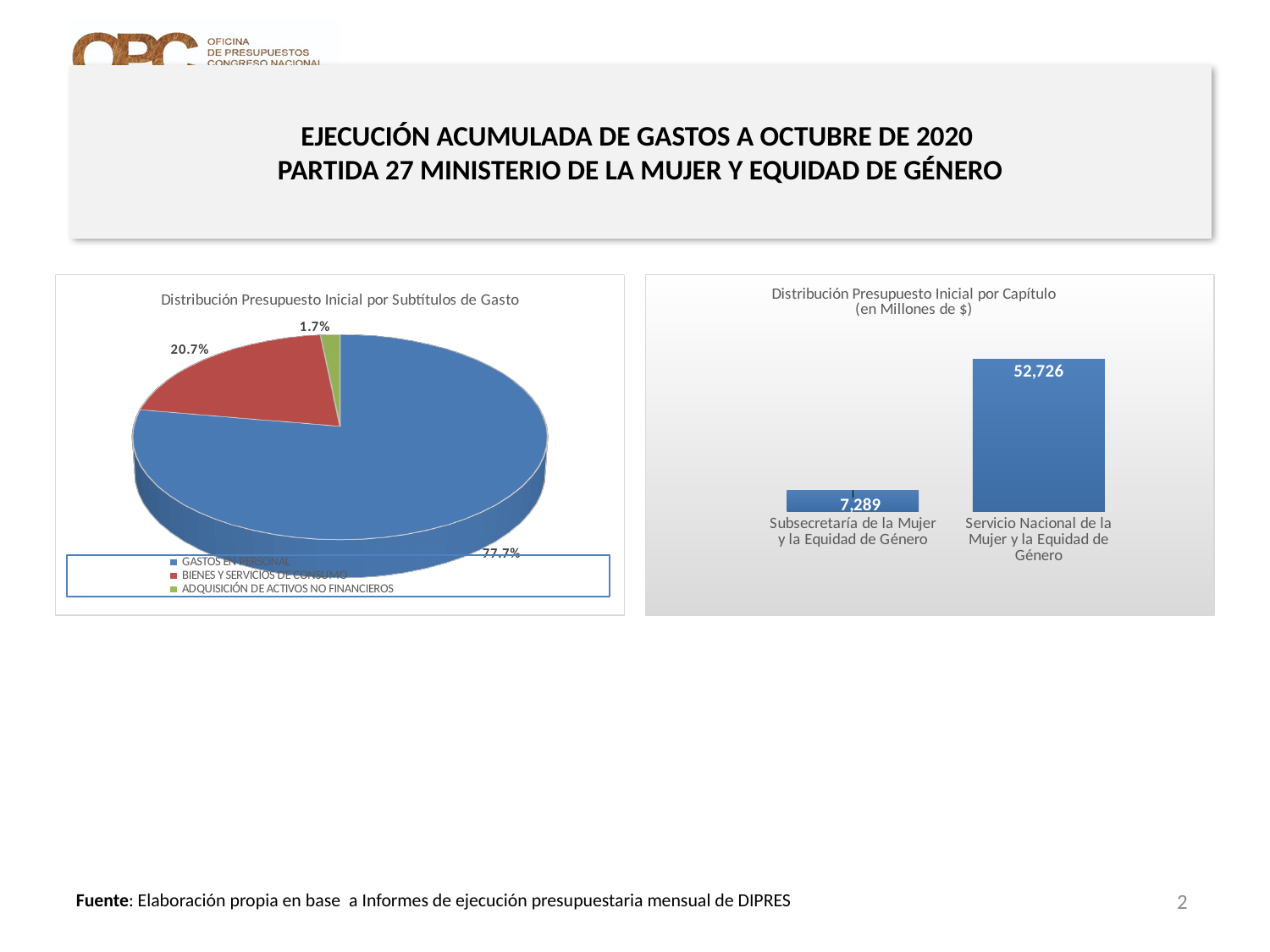
In the chart 'Distribución Presupuesto Inicial por Capítulo', what is the difference between the two bars? 45,437 In the pie chart 'Distribución Presupuesto Inicial por Subtítulos de Gasto', what share does GASTOS EN PERSONAL have? 77.7% In the chart 'Distribución Presupuesto Inicial por Capítulo', what is the value for Subsecretaría de la Mujer y la Equidad de Género? 7,289 In the chart 'Distribución Presupuesto Inicial por Capítulo', what is the value for Servicio Nacional de la Mujer y la Equidad de Género? 52,726 In the pie chart on the left, which category has the smallest slice? ADQUISICIÓN DE ACTIVOS NO FINANCIEROS In the pie chart on the left, how many slices are there? 3 In the pie chart on the left, which category has the largest slice? GASTOS EN PERSONAL What type of chart is the chart on the left of the slide? Pie chart In the pie chart on the left, what is the difference in percentage points between GASTOS EN PERSONAL and BIENES Y SERVICIOS DE CONSUMO? 57.0 percentage points In the pie chart 'Distribución Presupuesto Inicial por Subtítulos de Gasto', what share does BIENES Y SERVICIOS DE CONSUMO have? 20.7% What type of chart is the chart on the right of the slide? Bar chart In the pie chart 'Distribución Presupuesto Inicial por Subtítulos de Gasto', what share does ADQUISICIÓN DE ACTIVOS NO FINANCIEROS have? 1.7%